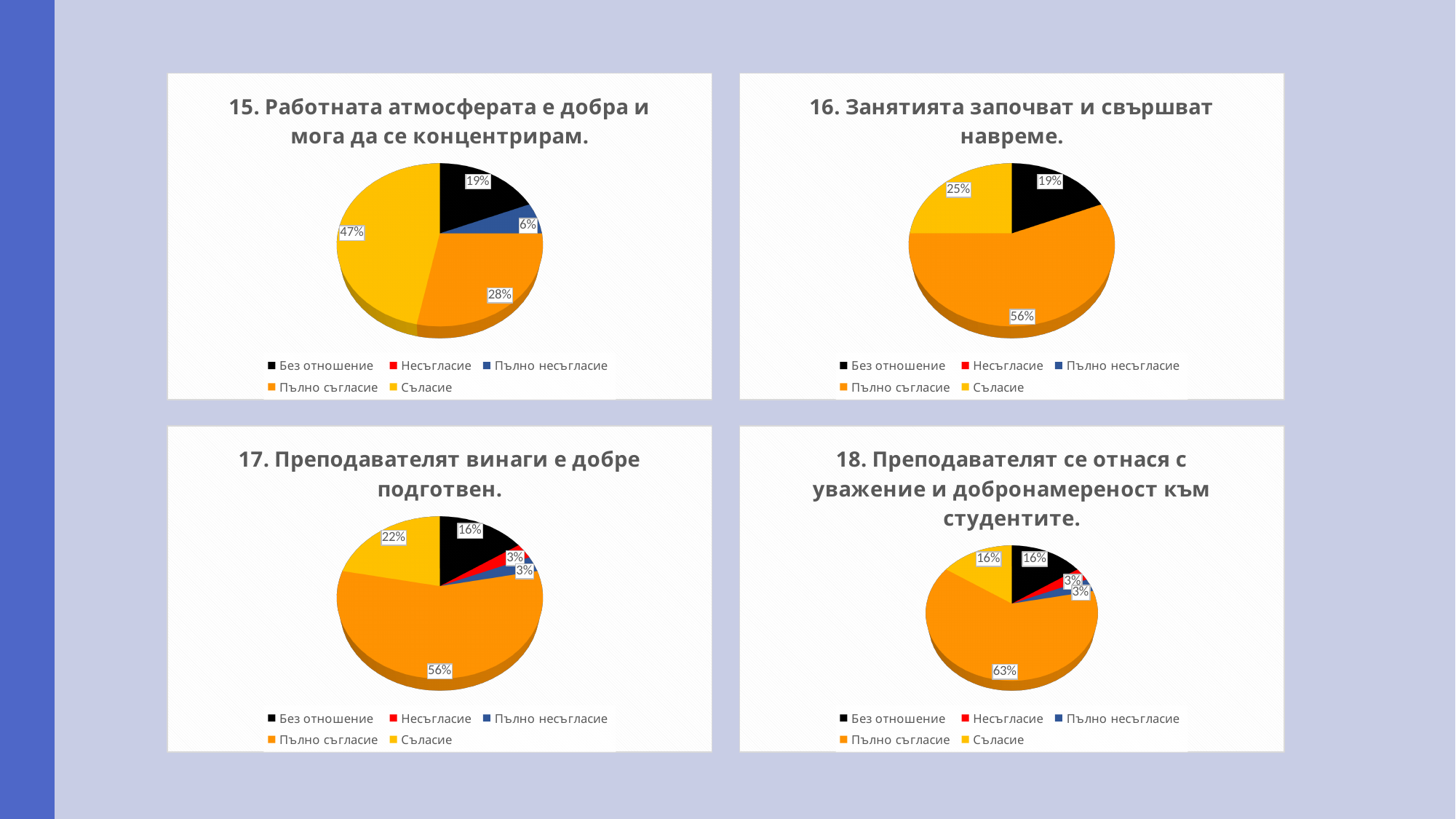
In the chart titled "16. Занятията започват и свършват навреме.", what is the difference between the Пълно съгласие and Съгласие slices? 31% In the chart titled "15. Работната атмосферата е добра и мога да се концентрирам.", what percentage is shown for Съгласие? 47% In the chart titled "16. Занятията започват и свършват навреме.", which is larger, Без отношение or Съгласие? Съгласие In the chart titled "18. Преподавателят се отнася с уважение и добронамереност към студентите.", what is the difference between the Пълно съгласие and Без отношение slices? 47% How many entries does the legend of the chart titled "17. Преподавателят винаги е добре подготвен." list? 5 In the chart titled "16. Занятията започват и свършват навреме.", what percentage is shown for Пълно съгласие? 56% In the chart titled "15. Работната атмосферата е добра и мога да се концентрирам.", what percentage is shown for Пълно несъгласие? 6% In the chart titled "17. Преподавателят винаги е добре подготвен.", what percentage is shown for Съгласие? 22% In the chart titled "17. Преподавателят винаги е добре подготвен.", which category has the largest slice? Пълно съгласие What type of chart is used for "18. Преподавателят се отнася с уважение и добронамереност към студентите."? Pie chart In the chart titled "15. Работната атмосферата е добра и мога да се концентрирам.", which category has the largest slice? Съгласие In the chart titled "18. Преподавателят се отнася с уважение и добронамереност към студентите.", what percentage is shown for Пълно съгласие? 63%